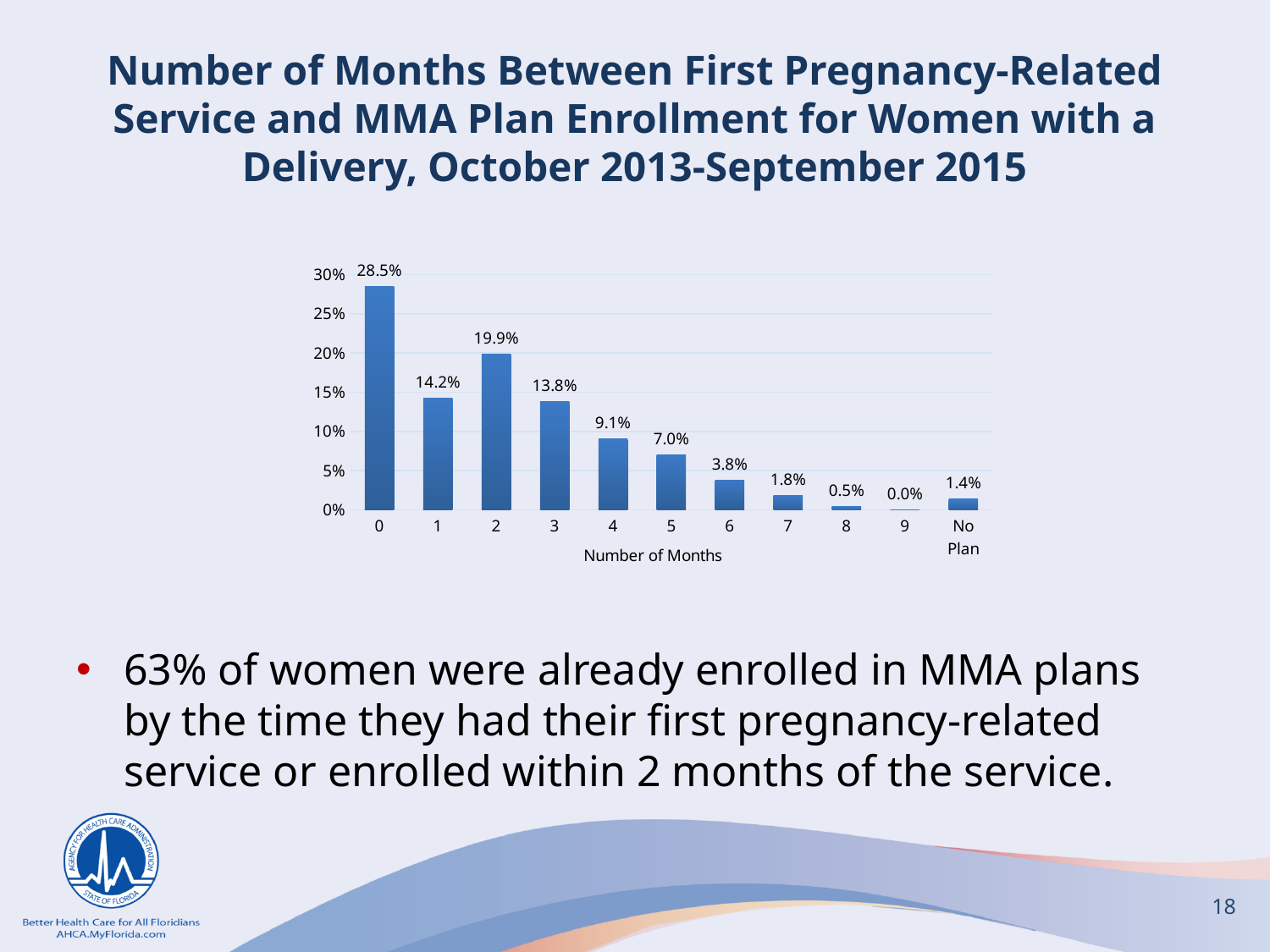
Which category has the lowest percentage? 9 What is the difference between the percentages for 0 months and 1 month? 14.3% What is the value shown for 2 months? 19.9% How many categories are shown on the x axis? 11 What is the label of the x axis? Number of Months Which is larger, the value for 1 month or the value for 3 months? 1 month Is the value for 4 months greater or less than 10%? less What kind of chart is shown on the slide? bar chart Which number of months has the highest percentage? 0 What percentage is shown for the 'No Plan' category? 1.4% Do the values generally rise or fall from 0 months to 9 months? fall What percentage of women enrolled in an MMA plan 0 months after their first pregnancy-related service? 28.5%